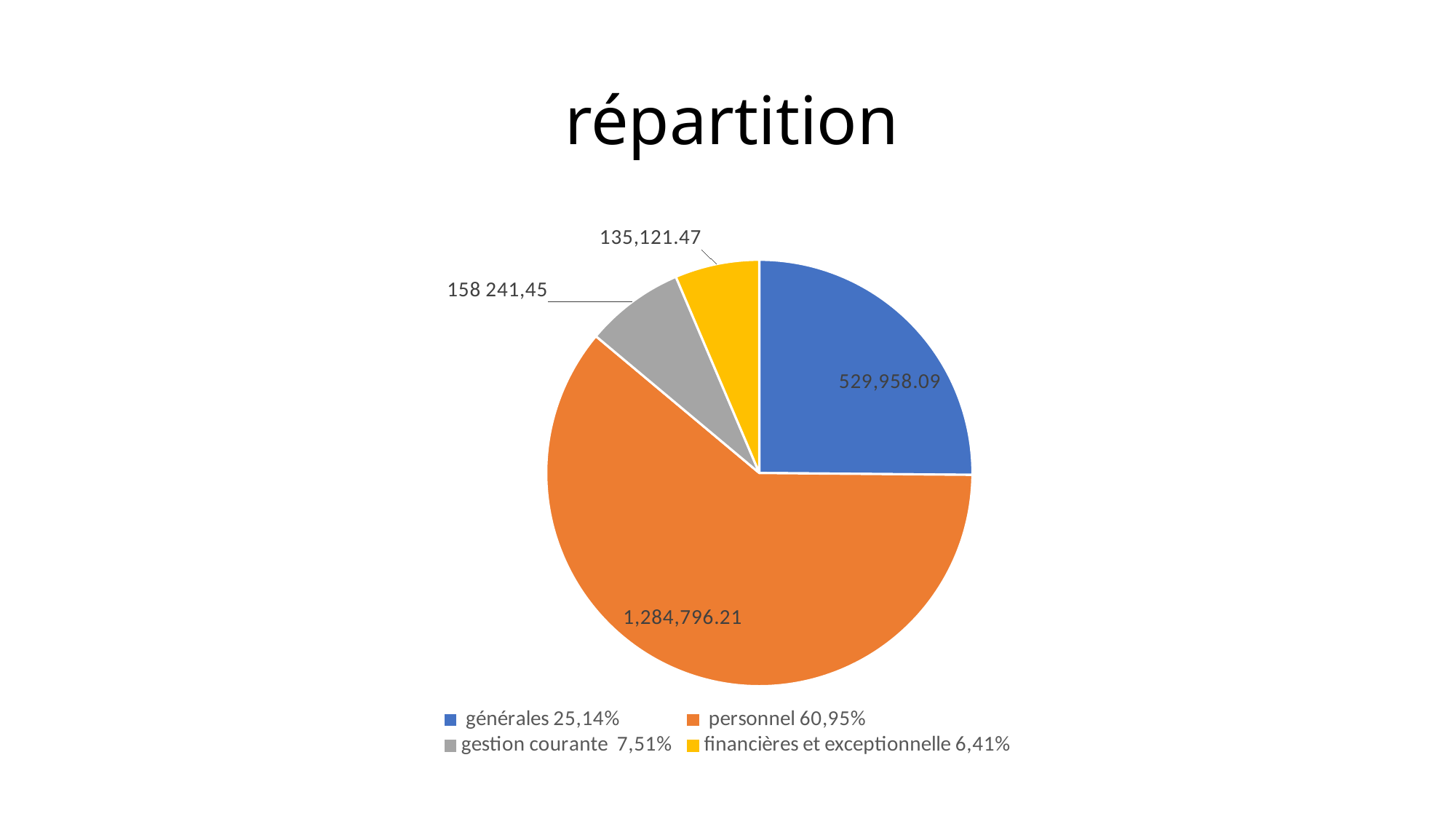
What share of the pie does personnel represent, according to the legend? 60,95% What is the value shown for the financières et exceptionnelle slice? 135,121.47 What is the value shown for the gestion courante slice? 158 241,45 What is the value shown for the générales slice? 529,958.09 Which category has the largest slice of the pie? personnel What type of chart is shown on the slide? pie chart What is the difference between the personnel value and the générales value? 754,838.12 What share of the pie does gestion courante represent, according to the legend? 7,51% Which is larger, the générales slice or the gestion courante slice? générales How many slices does the pie chart have? 4 Which category has the smallest slice of the pie? financières et exceptionnelle What is the value shown for the personnel slice? 1,284,796.21